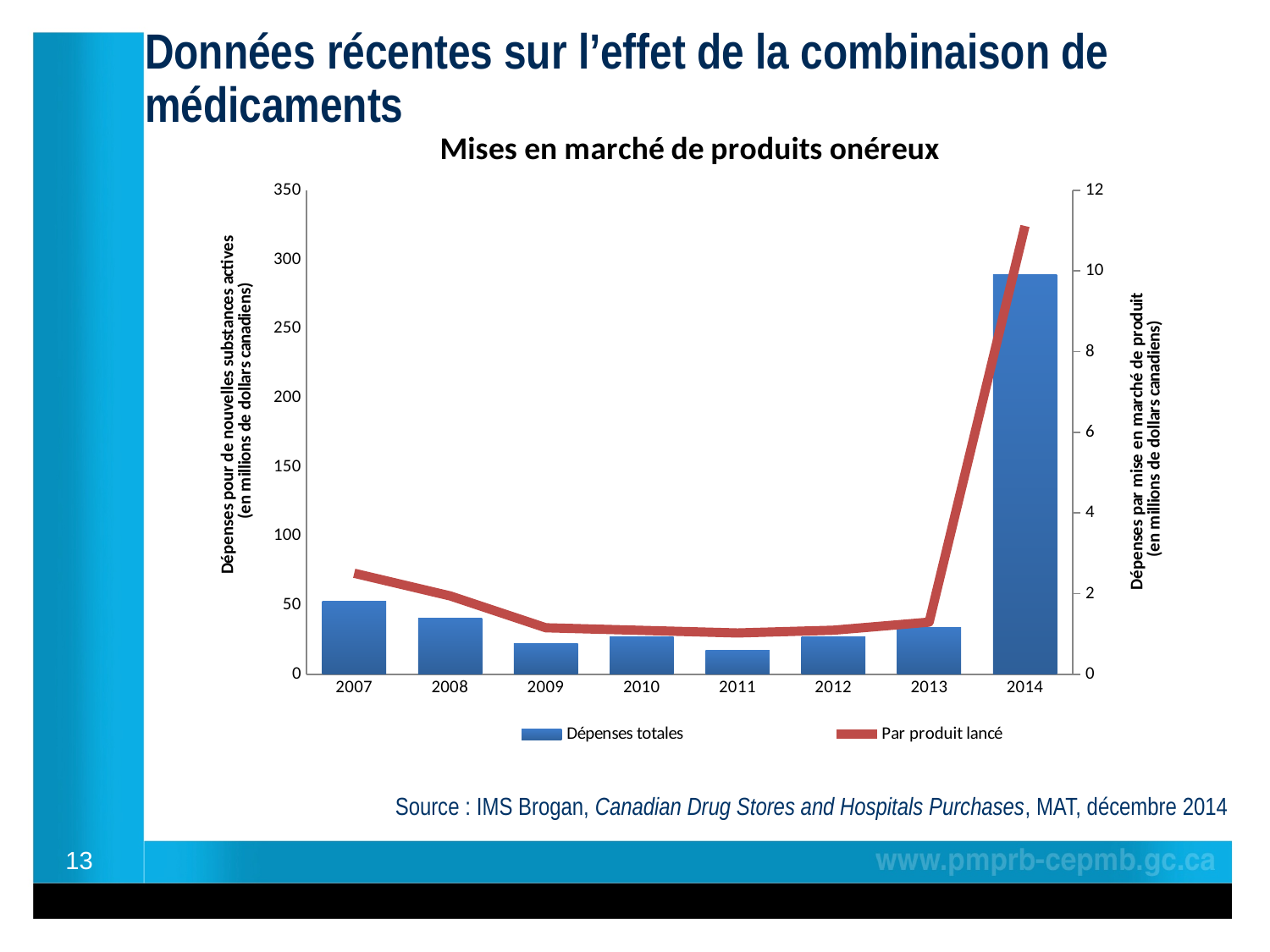
Is the value for Par produit lancé in 2014 greater or less than 10? greater Which year has the lowest value for Dépenses totales? 2011 How many series does the chart's legend list? 2 How many years are shown on the x axis of the chart? 8 Which year has the highest value for Dépenses totales? 2014 Is the value for Dépenses totales in 2014 greater or less than 250? greater Which year has the highest value for Par produit lancé? 2014 Is the value for Dépenses totales in 2007 greater or less than 100? less What kind of chart is shown on the slide? A combination bar and line chart Does the Par produit lancé line rise or fall from 2007 to 2011? fall What is the title of the chart? Mises en marché de produits onéreux Which is larger, Dépenses totales in 2007 or in 2008? 2007